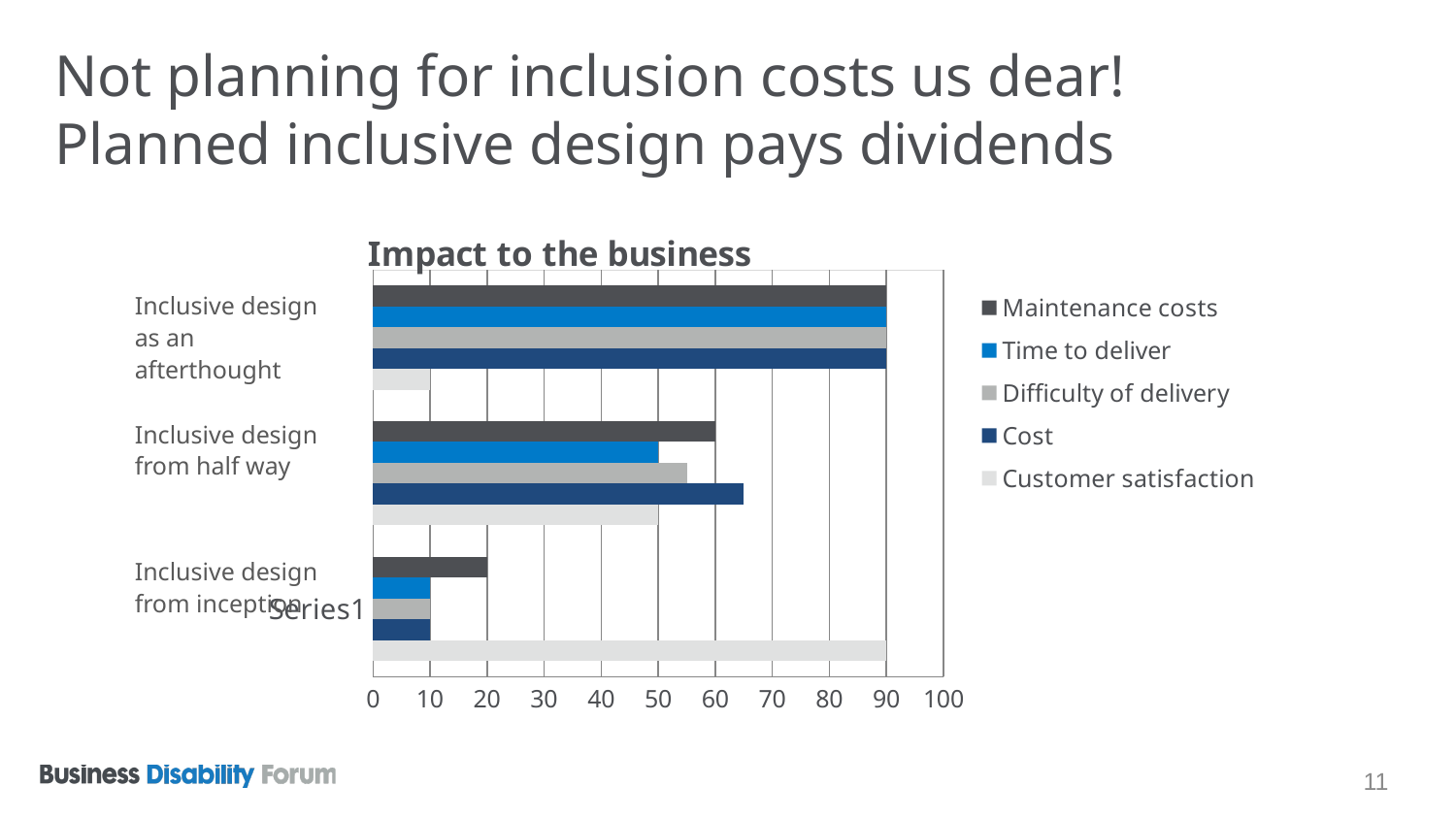
Which category has the highest Customer satisfaction value? Inclusive design from inception What is the Maintenance costs value for 'Inclusive design from half way'? 60 What is the Maintenance costs value for 'Inclusive design as an afterthought'? 90 Is the Cost value for 'Inclusive design from half way' greater or less than 60? greater What is the title of the chart? Impact to the business Which category has the lowest Maintenance costs value? Inclusive design from inception What kind of chart is shown on the slide? Bar chart What is the difference between the Maintenance costs value for 'Inclusive design as an afterthought' and for 'Inclusive design from inception'? 70 How many categories are shown on the chart's vertical axis? 3 What is the Customer satisfaction value for 'Inclusive design as an afterthought'? 10 How many series does the chart legend list? 5 What is the Customer satisfaction value for 'Inclusive design from inception'? 90